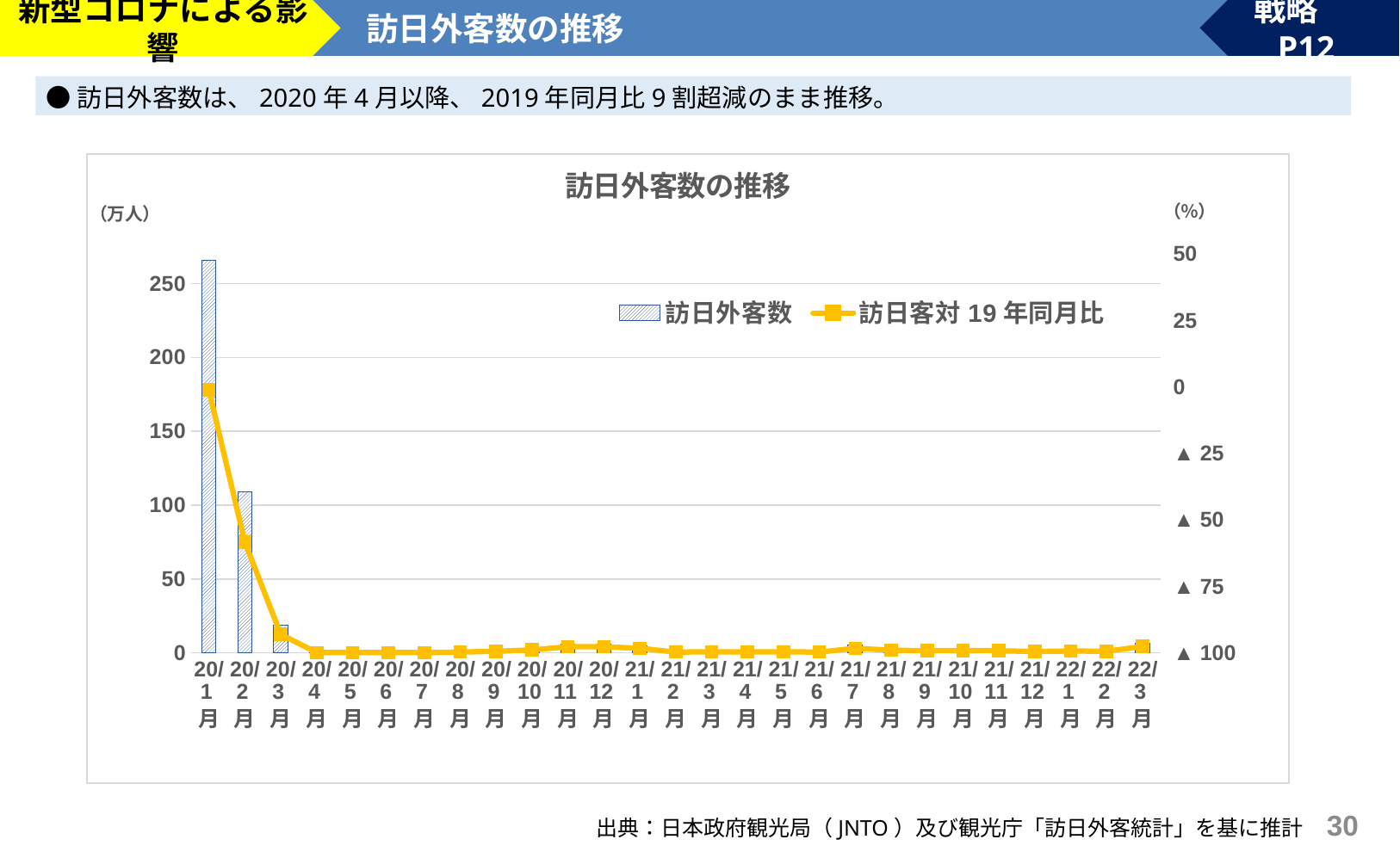
How many months are shown along the x axis? 27 What kind of chart is shown on the slide? A combined bar and line chart Do the 訪日外客数 bars rise or fall from 20/1月 to 20/4月? fall Is the 訪日客対19年同月比 value for 20/4月 greater or less than ▲75? less Is the 訪日外客数 bar for 20/1月 greater or less than 250? greater Is the 訪日外客数 bar for 20/3月 greater or less than 50? less How many series does the legend list? 2 What is the title of the chart? 訪日外客数の推移 Which is larger, the 訪日外客数 bar for 20/1月 or for 20/2月? 20/1月 Which month has the highest bar for 訪日外客数? 20/1月 What unit is shown on the left axis of the chart? 万人